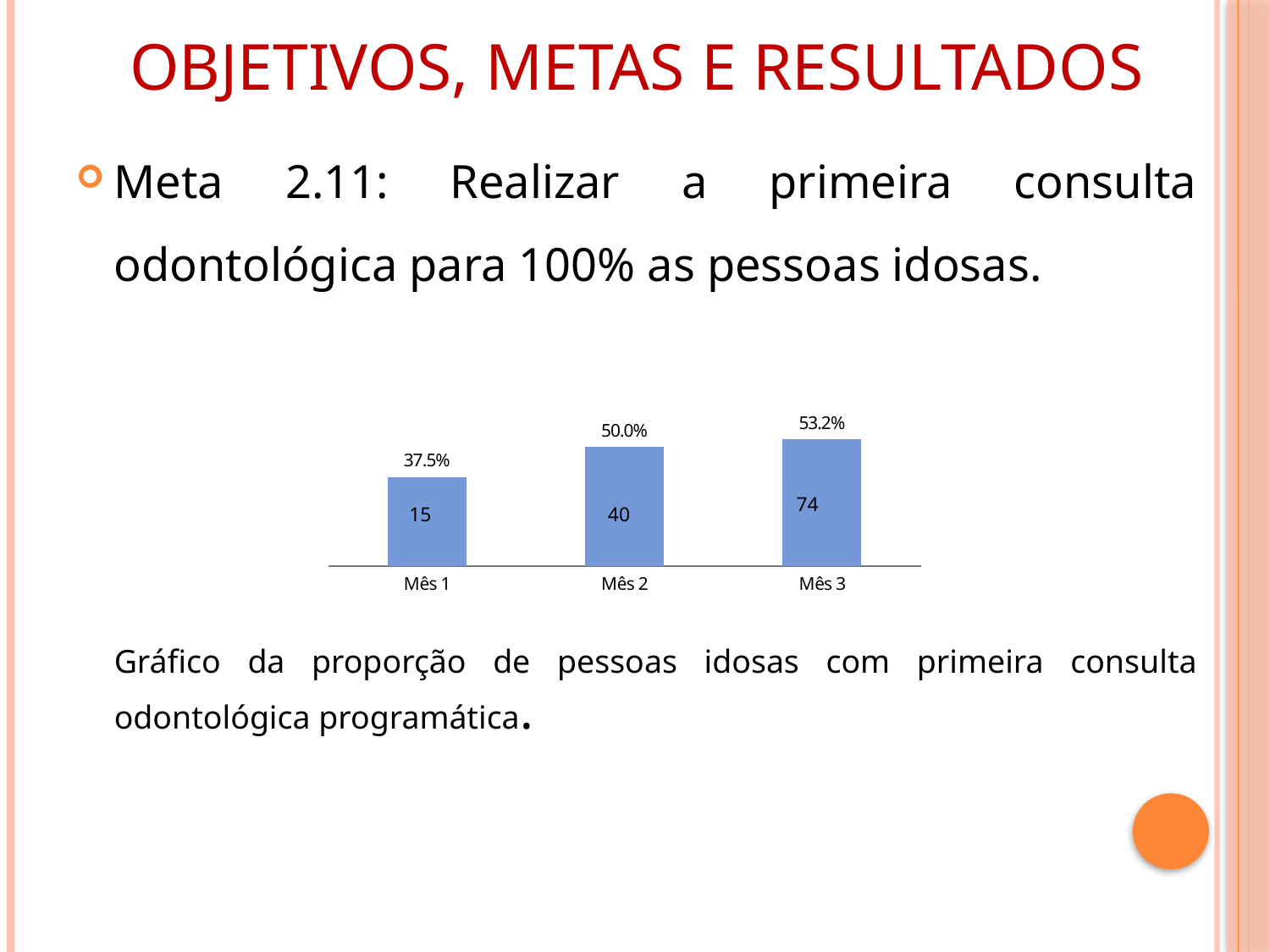
What is the difference in percentage points between Mês 2 and Mês 1? 12.5 Which is larger, the percentage for Mês 2 or for Mês 3? Mês 3 What percentage is shown for Mês 3? 53.2% What kind of chart is shown on the slide? Bar chart What number is printed inside the bar for Mês 3? 74 How many months are shown on the chart? 3 Which month has the highest percentage? Mês 3 What percentage is shown for Mês 1? 37.5% What number is printed inside the bar for Mês 1? 15 Do the percentages rise or fall from Mês 1 to Mês 3? Rise What percentage is shown for Mês 2? 50.0% Which month has the lowest percentage? Mês 1